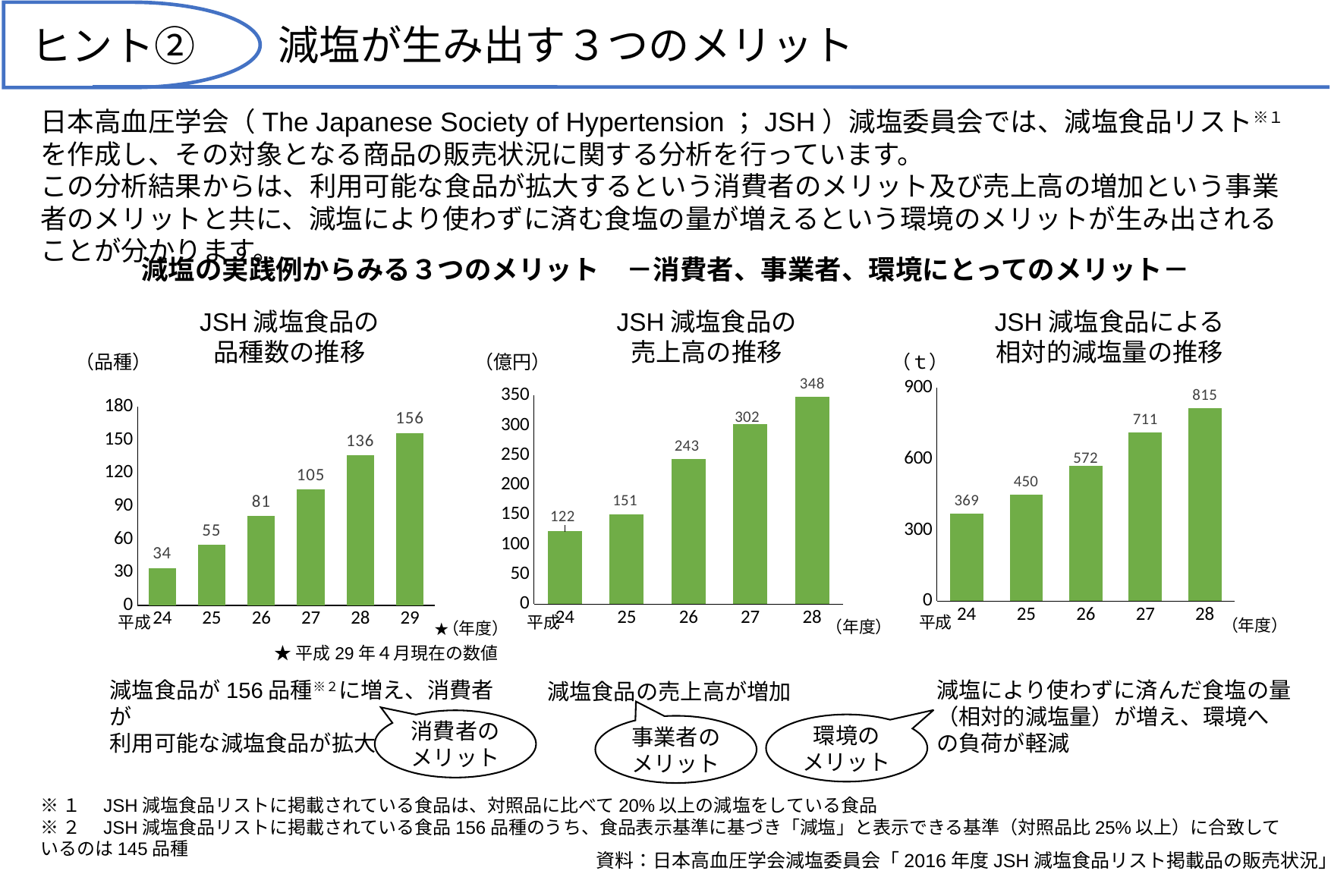
In the chart titled 'JSH減塩食品の売上高の推移', what is the value for 平成26? 243 In the chart titled 'JSH減塩食品による相対的減塩量の推移', what is the value for 平成27? 711 What kind of chart is the chart titled 'JSH減塩食品による相対的減塩量の推移'? bar chart In the chart titled 'JSH減塩食品の売上高の推移', which year has the highest value? 平成28 In the chart titled 'JSH減塩食品の品種数の推移', what is the value for 平成24? 34 In the chart titled 'JSH減塩食品の品種数の推移', what is the value for 平成29? 156 In the chart titled 'JSH減塩食品の売上高の推移', what is the difference between the values for 平成28 and 平成24? 226 In the chart titled 'JSH減塩食品の品種数の推移', what is the difference between the values for 平成28 and 平成27? 31 In the chart titled 'JSH減塩食品による相対的減塩量の推移', which year has the lowest value? 平成24 In the chart titled 'JSH減塩食品の品種数の推移', how many bars are plotted? 6 In the chart titled 'JSH減塩食品の売上高の推移', do the values rise or fall from 平成24 to 平成28? rise In the chart titled 'JSH減塩食品による相対的減塩量の推移', which is larger, the value for 平成25 or 平成26? 平成26